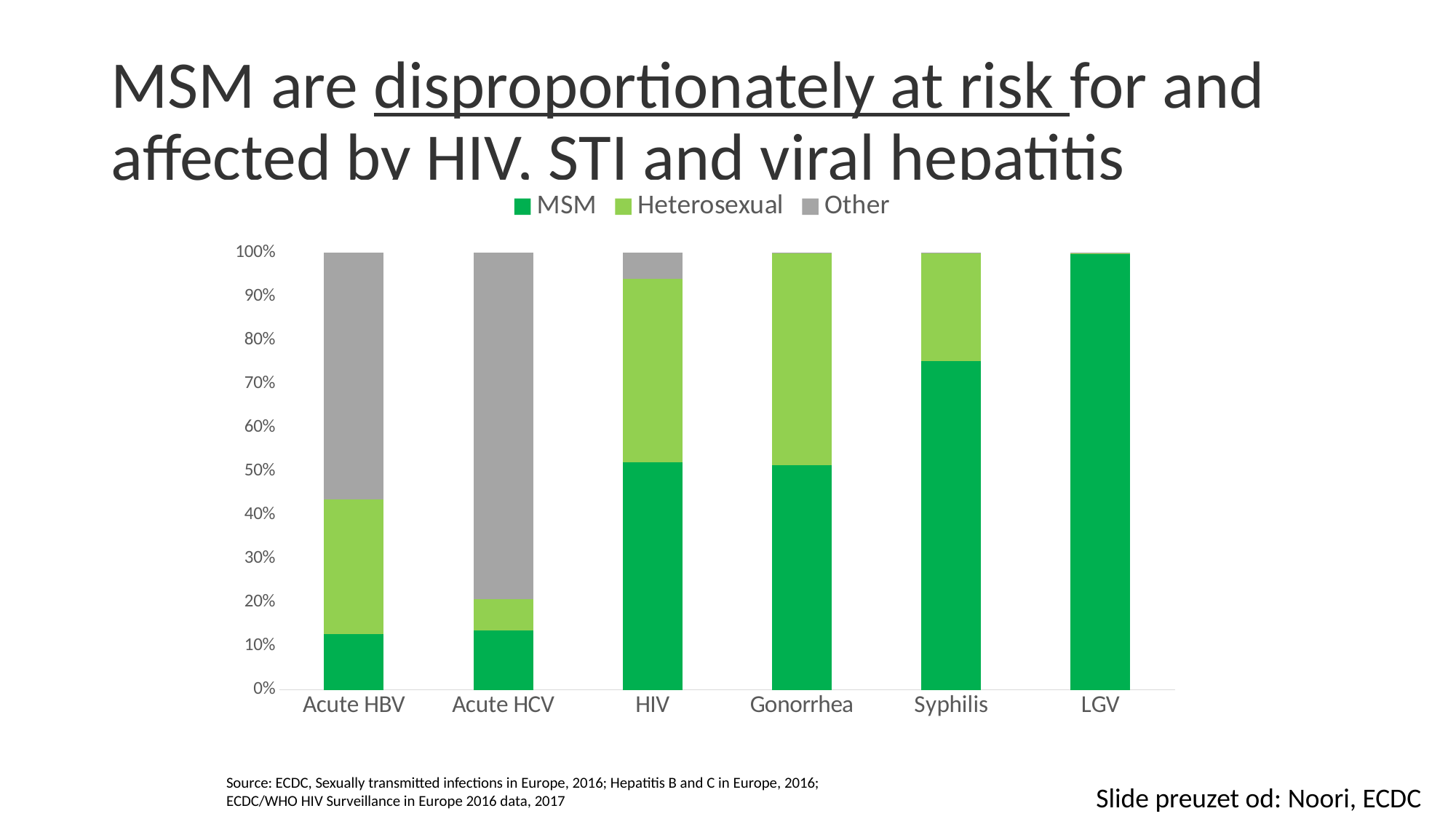
Which has the larger MSM share, Syphilis or Gonorrhea? Syphilis Which series in the legend is shown in grey? Other How many categories are shown along the x axis of the chart? 6 Is the MSM share for HIV greater or less than 40%? greater Is the MSM share for Gonorrhea greater or less than 60%? less Which category has the largest Other share? Acute HCV How many series does the chart's legend list? 3 What kind of chart is shown on the slide? Stacked bar chart Which category has the largest MSM share? LGV Is the MSM share for Syphilis greater or less than 70%? greater Which has the larger Heterosexual share, Acute HBV or Acute HCV? Acute HBV